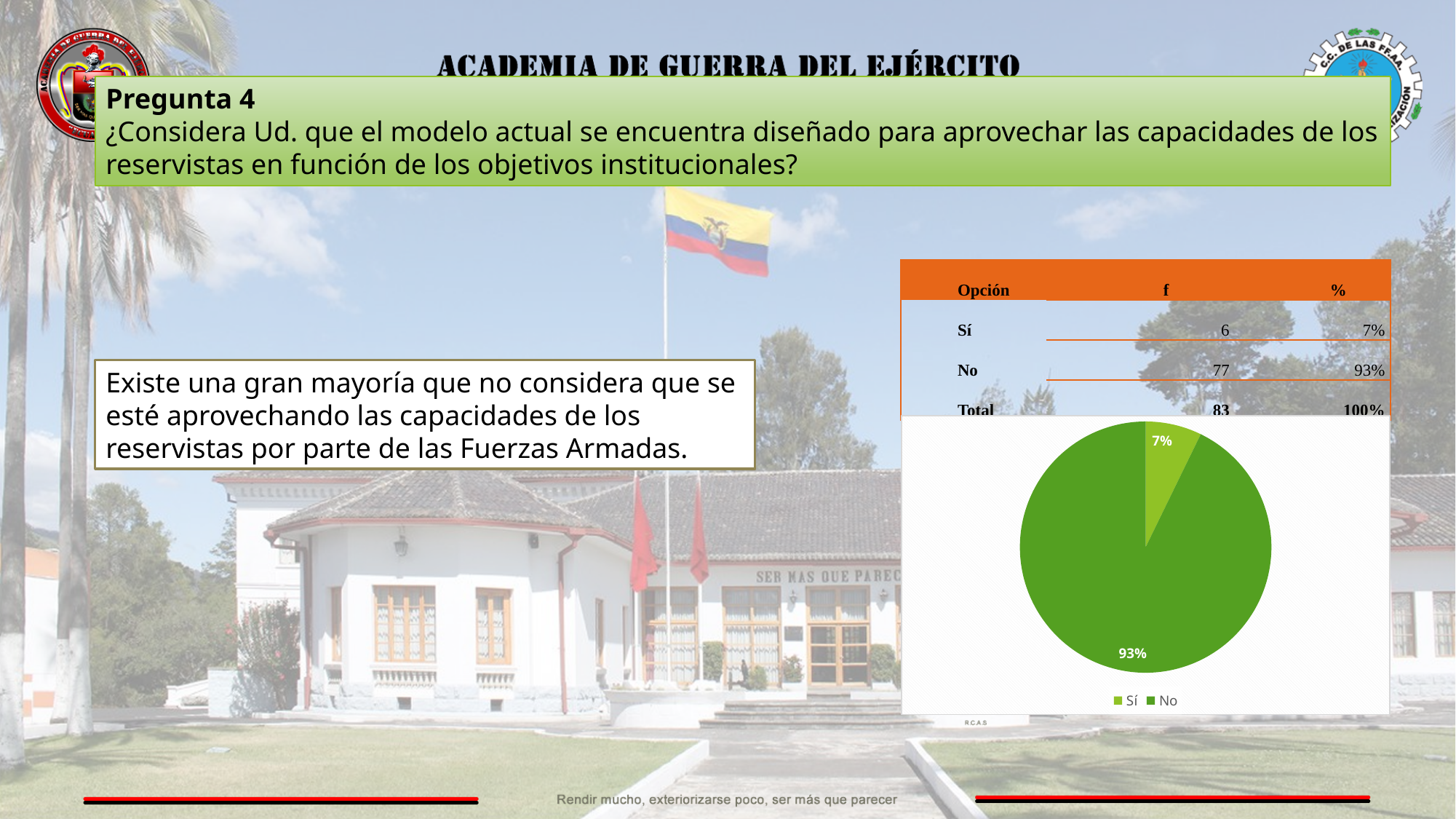
What percentage does the 'Sí' slice of the pie chart show? 7% What is the difference in percentage points between the 'No' and 'Sí' slices of the pie chart? 86 Which is larger in the pie chart, 'Sí' or 'No'? No Which slice of the pie chart is the largest? No What kind of chart is shown on the slide? pie chart How many entries does the pie chart's legend list? 2 Which legend entry of the pie chart is shown in the darker green colour? No How many slices does the pie chart have? 2 What share of the pie does the 'No' slice represent? 93% What percentage does the 'No' slice of the pie chart show? 93% Which slice of the pie chart is the smallest? Sí What are the two legend entries of the pie chart? Sí and No